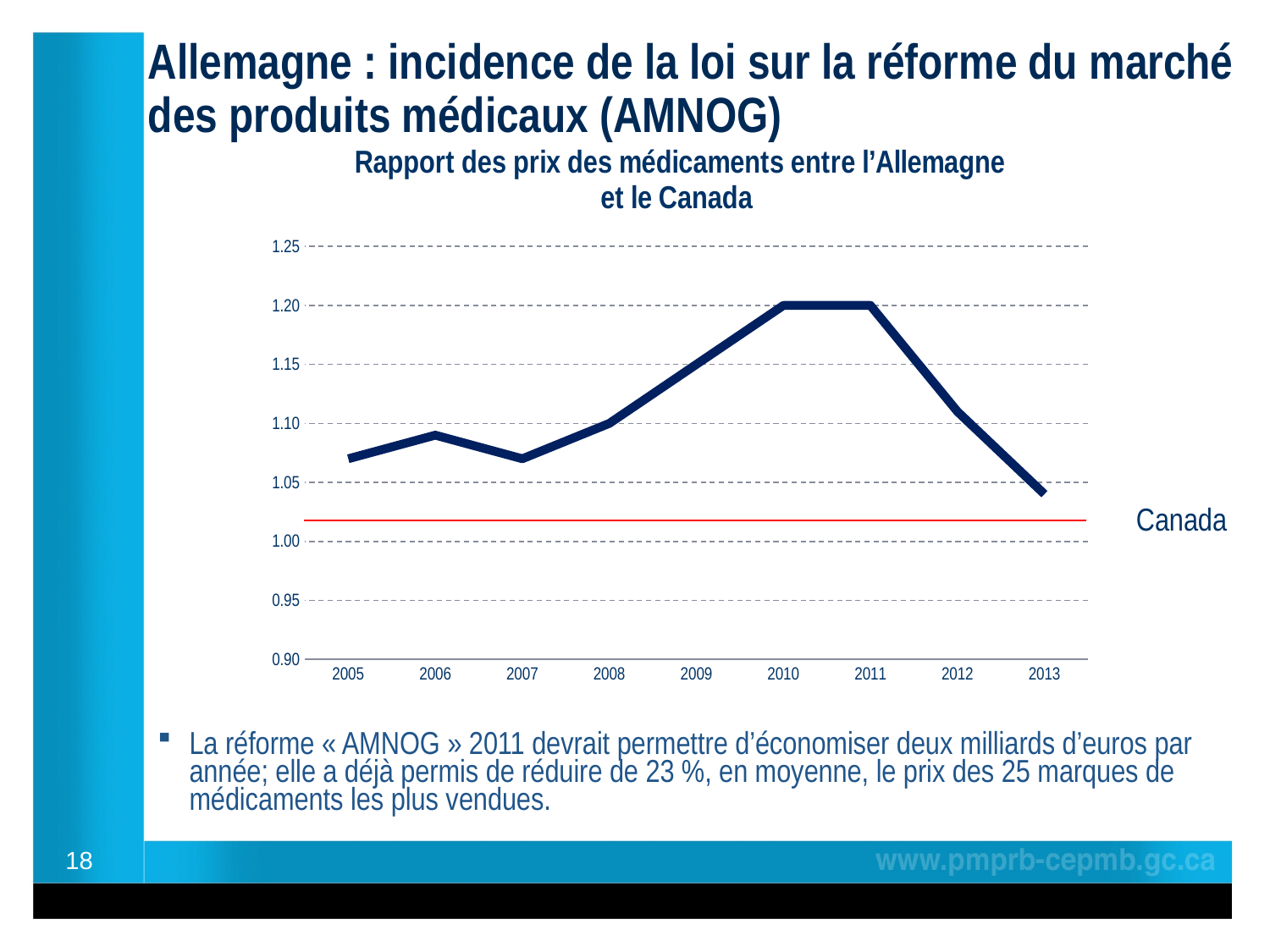
Which year has the lowest price ratio on the chart? 2013 Is the value for 2013 greater or less than 1.05? less What is the price ratio value for 2010? 1.20 Is the value for 2012 greater or less than 1.15? less How many years are shown on the x axis of the chart? 9 What is the price ratio value for 2011? 1.20 Does the line rise or fall from 2011 to 2013? fall Which year has the higher value, 2009 or 2012? 2009 What kind of chart is shown on the slide? line chart Is the value for 2005 greater or less than 1.05? greater What label is shown next to the red horizontal reference line? Canada